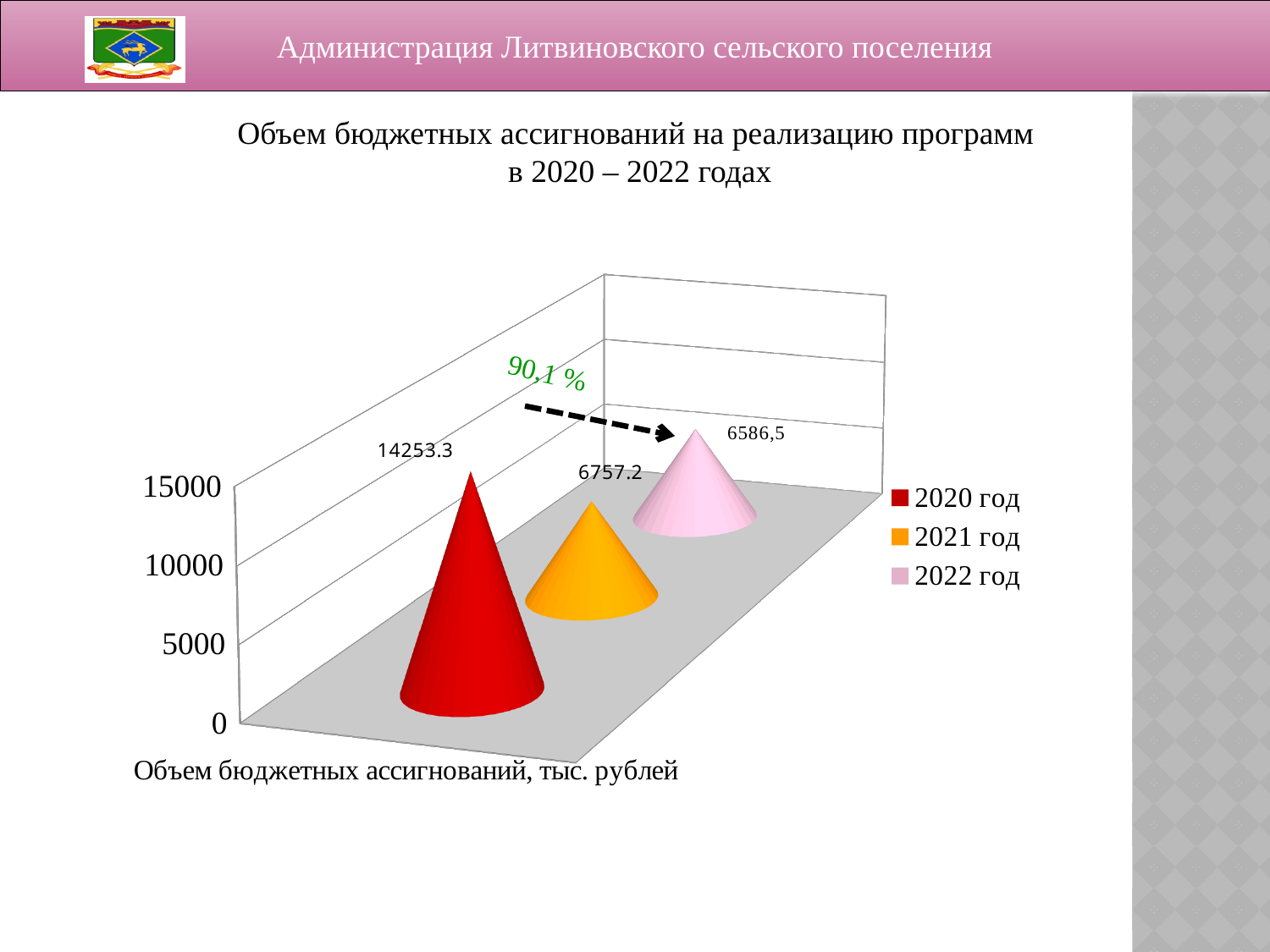
Which year has the highest value? 2020 год What is the difference between the values for 2021 год and 2022 год? 170.7 What is the value for 2022 год? 6586,5 Do the values rise or fall from 2020 to 2022? fall What percentage is written in green above the dashed arrow? 90,1 % What is the value for 2020 год? 14253.3 What is the difference between the values for 2020 год and 2021 год? 7496.1 How many series does the legend list? 3 What is the value for 2021 год? 6757.2 Is the value for 2021 год greater or less than 10000? less Which is larger, the value for 2021 год or 2022 год? 2021 год Which year has the lowest value? 2022 год